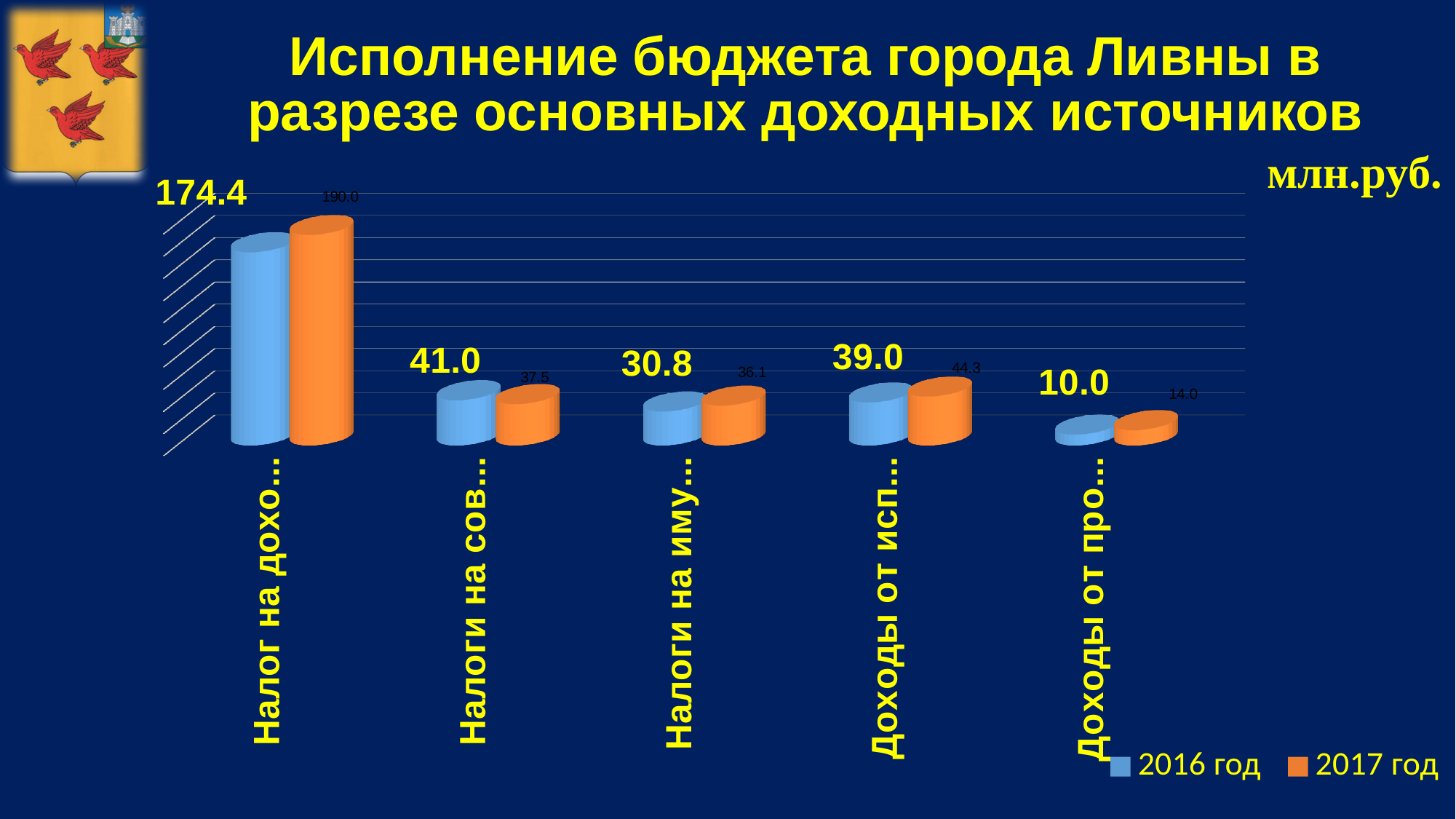
What unit is stated for the values on the chart? млн.руб. For the category Налоги на сов..., which year has the larger value, 2016 год or 2017 год? 2016 год Which category has the highest 2017 год value? Налог на дохо... Which category has the lowest 2016 год value? Доходы от про... What is the 2017 год value for the category labelled Доходы от исп...? 44.3 What is the difference between the 2017 год and 2016 год values for the first category (Налог на дохо...)? 15.6 How many categories are shown on the x axis? 5 What is the 2016 год value for the category labelled Налоги на иму...? 30.8 What kind of chart is shown on the slide? Bar chart What is the 2016 год value for the first category (Налог на дохо...)? 174.4 What is the 2017 год value for the first category (Налог на дохо...)? 190.0 How many series does the legend list? 2